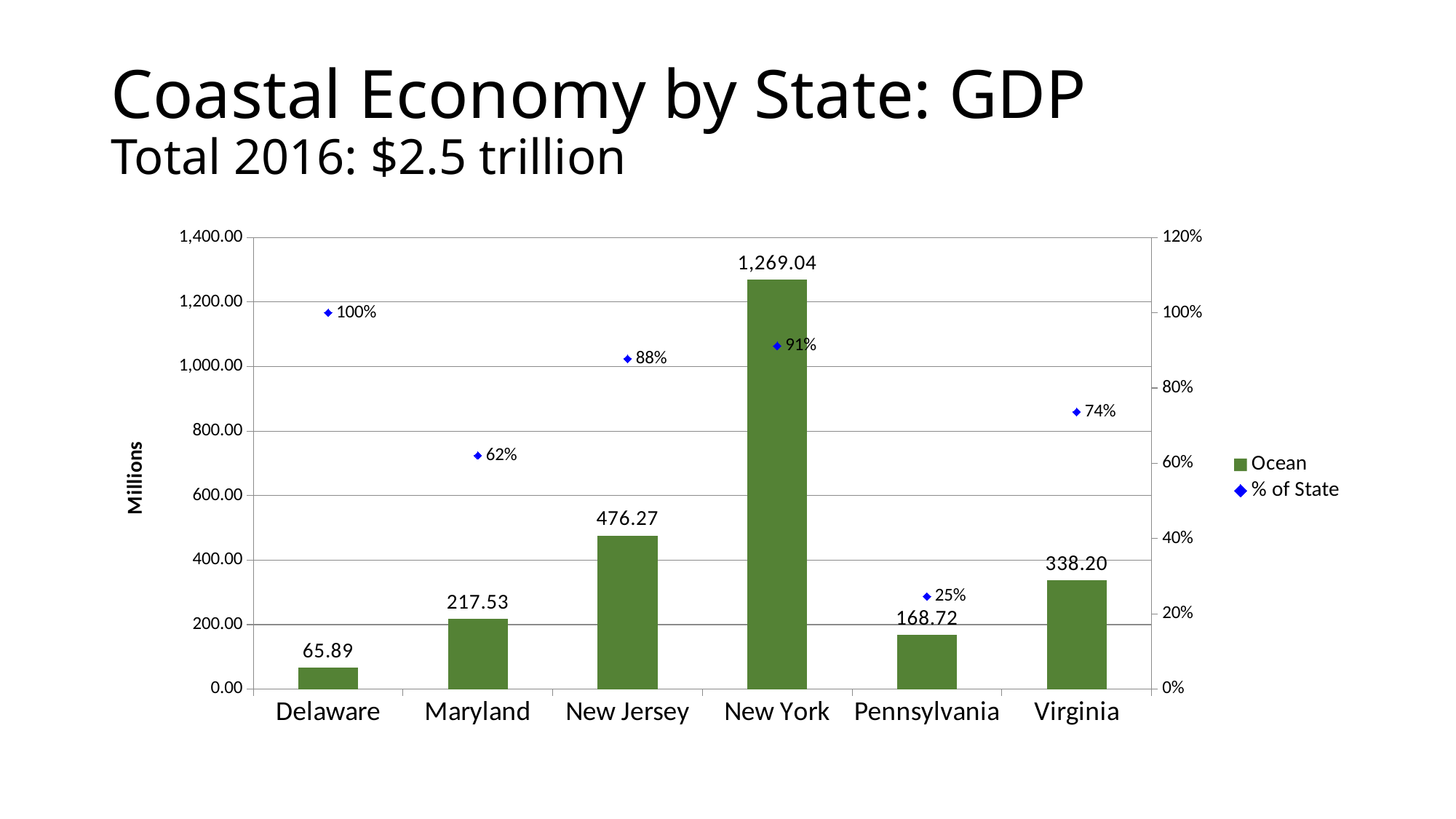
How many states are shown on the x axis? 6 Which state has the lowest % of State value? Pennsylvania How many series does the legend list? 2 Which state has the lowest Ocean GDP value? Delaware What is the % of State value for Maryland? 62% What is the % of State value for Delaware? 100% Which state has the highest Ocean GDP value? New York What is the Ocean GDP value for New Jersey? 476.27 What is the label on the left vertical axis? Millions What is the difference between the Ocean GDP values for Virginia and Pennsylvania? 169.48 What kind of chart is used for the Ocean series? Bar chart Which is larger, the Ocean GDP value for Maryland or for Virginia? Virginia